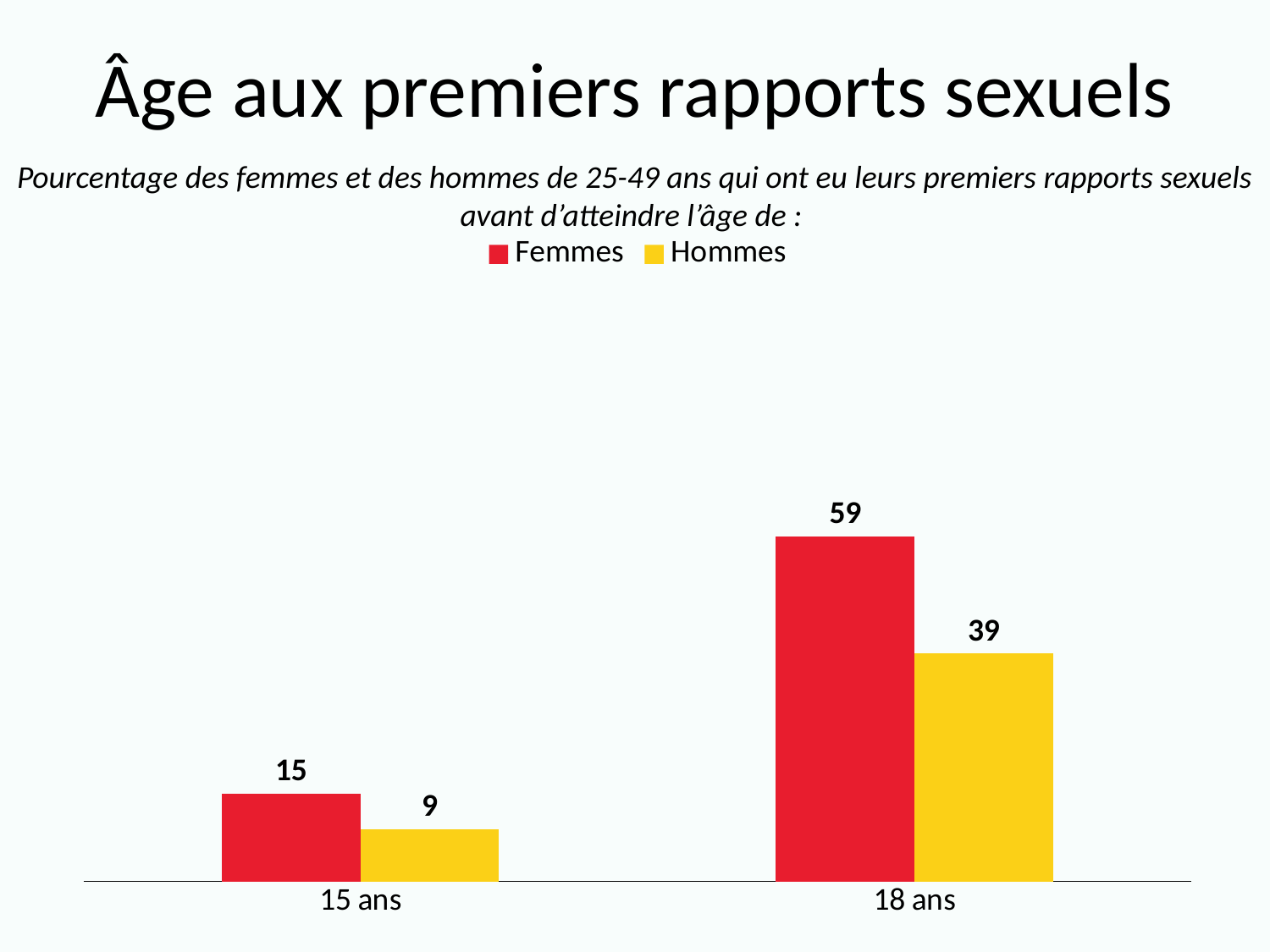
What is the difference between the Femmes and Hommes values at 15 ans? 6 How many categories are shown on the x axis? 2 Which is larger at 18 ans, Femmes or Hommes? Femmes What is the difference between the Femmes and Hommes values at 18 ans? 20 Which category has the lowest value for Hommes? 15 ans What is the value for Hommes at 18 ans? 39 Which category has the highest value for Femmes? 18 ans What is the value for Femmes at 15 ans? 15 How many series does the legend list? 2 What kind of chart is shown on the slide? Bar chart What is the value for Hommes at 15 ans? 9 What is the value for Femmes at 18 ans? 59